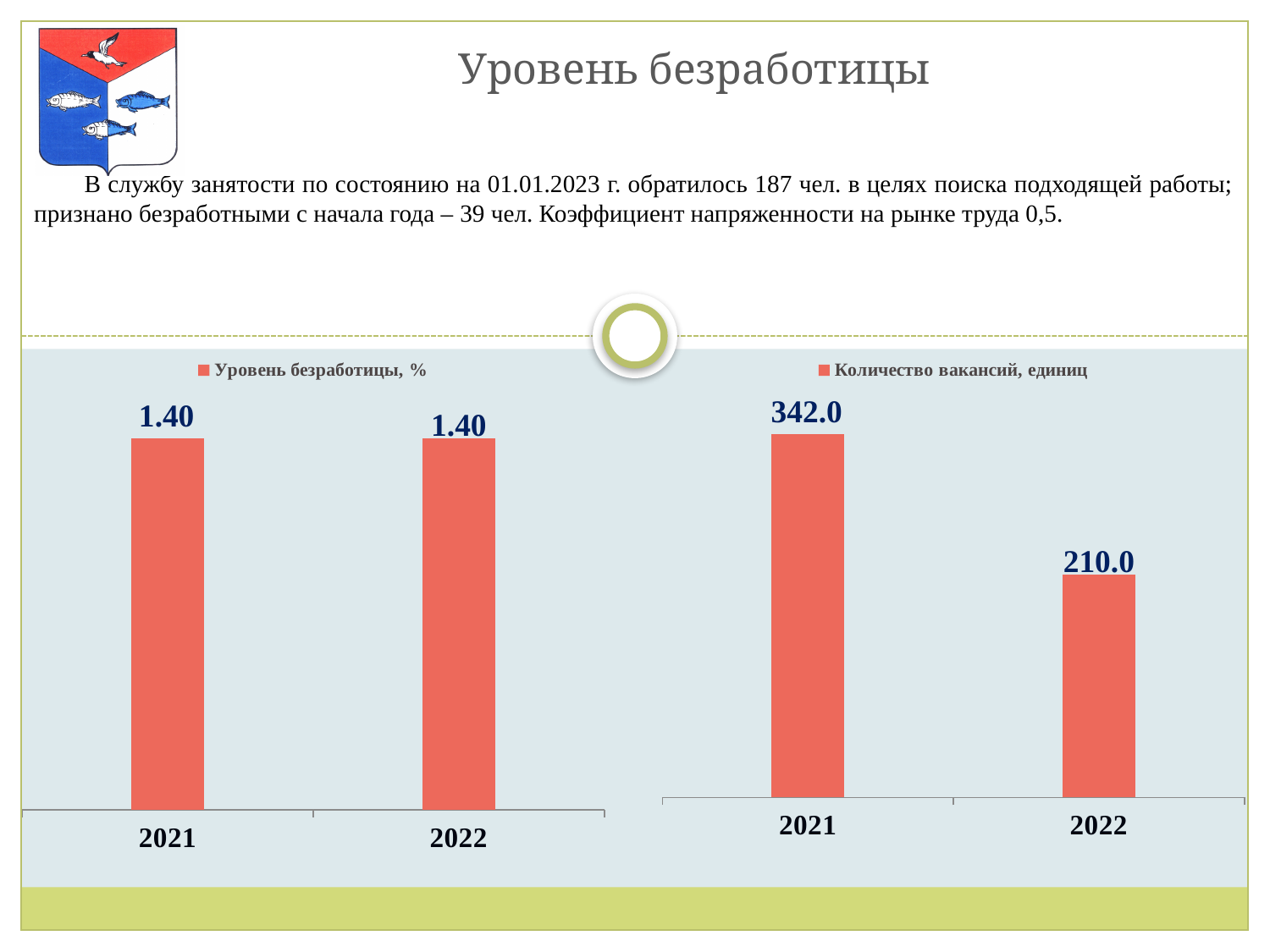
In the right chart (Количество вакансий, единиц), what is the difference between the 2021 and 2022 values? 132.0 What is the legend entry of the left chart? Уровень безработицы, % In the left chart (Уровень безработицы, %), what is the value for 2021? 1.40 In the right chart (Количество вакансий, единиц), do the values rise or fall from 2021 to 2022? fall In the right chart (Количество вакансий, единиц), what is the value for 2022? 210.0 In the right chart (Количество вакансий, единиц), what is the value for 2021? 342.0 In the right chart (Количество вакансий, единиц), which year has the highest value? 2021 What kind of chart is the right chart (Количество вакансий, единиц)? bar chart In the right chart (Количество вакансий, единиц), is the value for 2021 larger or smaller than the value for 2022? larger In the left chart (Уровень безработицы, %), how many years are shown on the x axis? 2 In the left chart (Уровень безработицы, %), what is the value for 2022? 1.40 In the right chart (Количество вакансий, единиц), which year has the lowest value? 2022